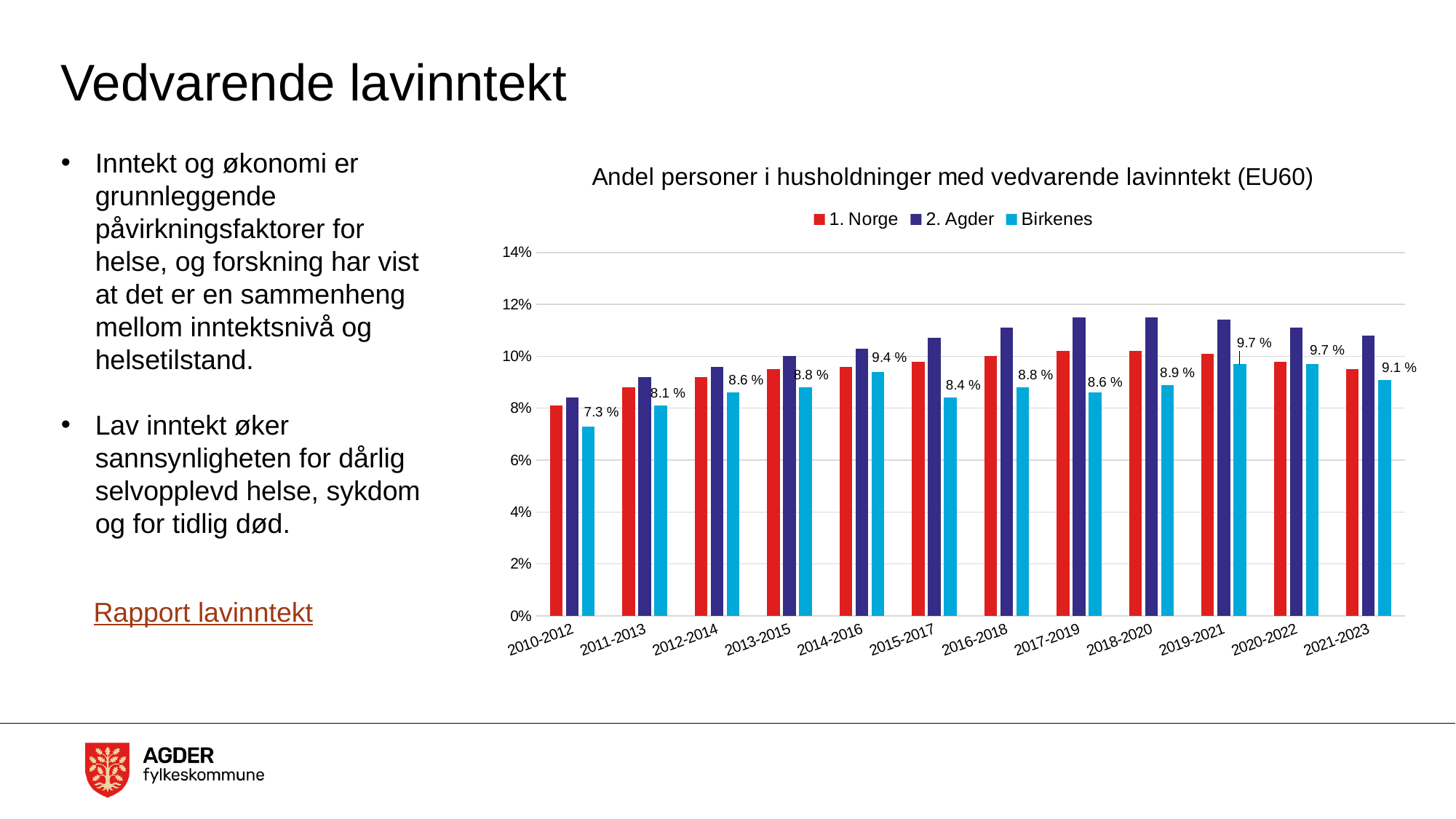
What is the value for Birkenes in 2018-2020? 8.9 % What is the value for Birkenes in 2014-2016? 9.4 % Is the value for 1. Norge in 2010-2012 greater or less than 10%? less Which is larger for Birkenes: the value for 2014-2016 or for 2015-2017? 2014-2016 What is the value for Birkenes in 2010-2012? 7.3 % Is the value for 2. Agder in 2017-2019 greater or less than 10%? greater How many series does the legend list? 3 In which period is the Birkenes value lowest? 2010-2012 How many periods are shown on the x axis? 12 In 2017-2019, which series has the higher value: 1. Norge or 2. Agder? 2. Agder What is the value for Birkenes in 2021-2023? 9.1 % What is the difference between the Birkenes values for 2020-2022 and 2010-2012? 2.4 %